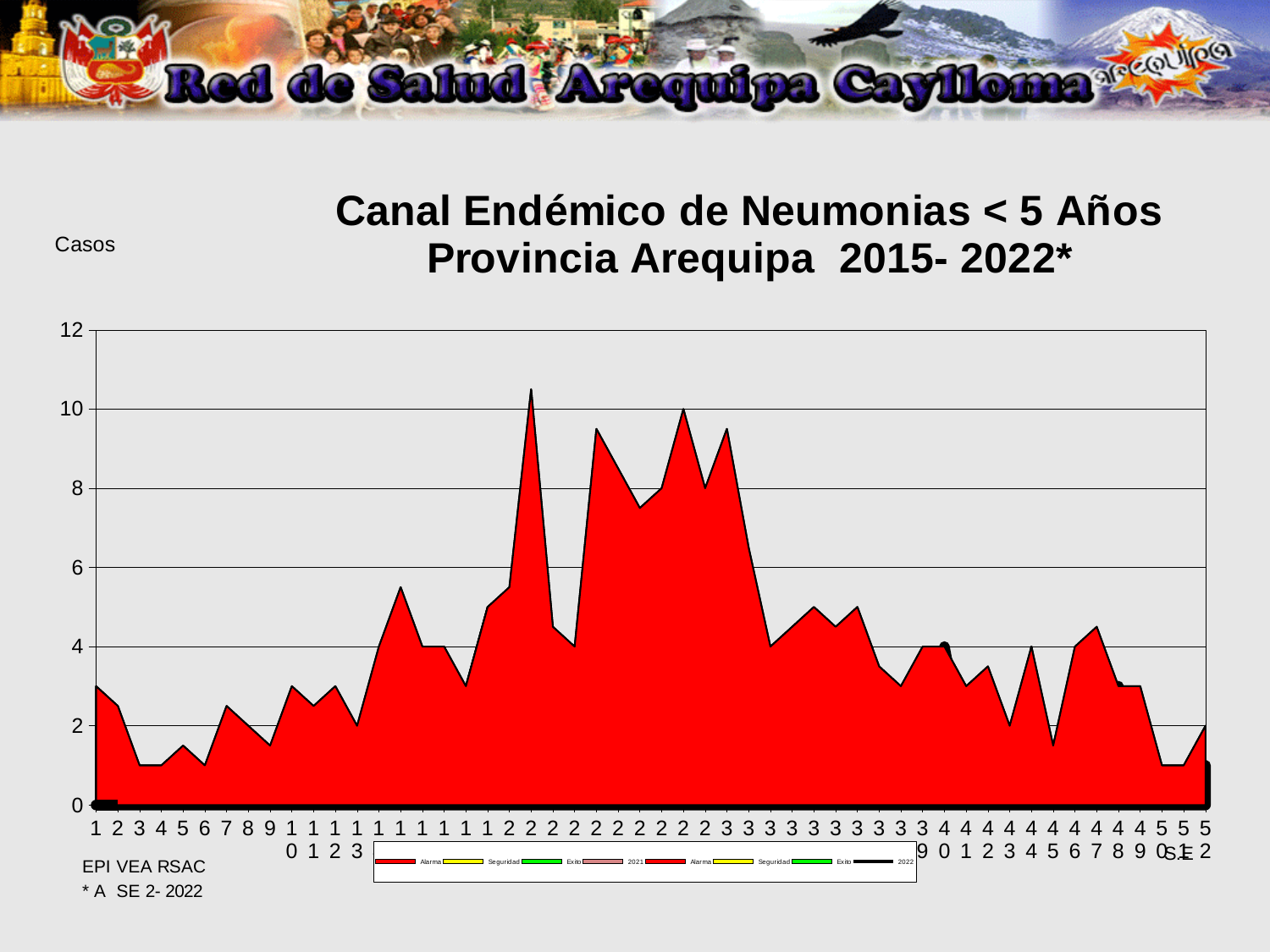
How many weeks (categories) are shown along the horizontal axis? 52 What is the title of the chart? Canal Endémico de Neumonias < 5 Años Provincia Arequipa 2015- 2022* What is the maximum value shown on the vertical axis? 12 What kind of chart is shown on the slide? area chart Between week 30 and week 40, do the values generally rise or fall? fall How many entries does the legend list? 8 Is the value for week 26 greater or less than 8? less Which week has the larger value, week 22 or week 50? week 22 Is the value for week 3 greater or less than 2? less What is the label of the vertical axis? Casos Is the value for week 22 greater or less than 10? less